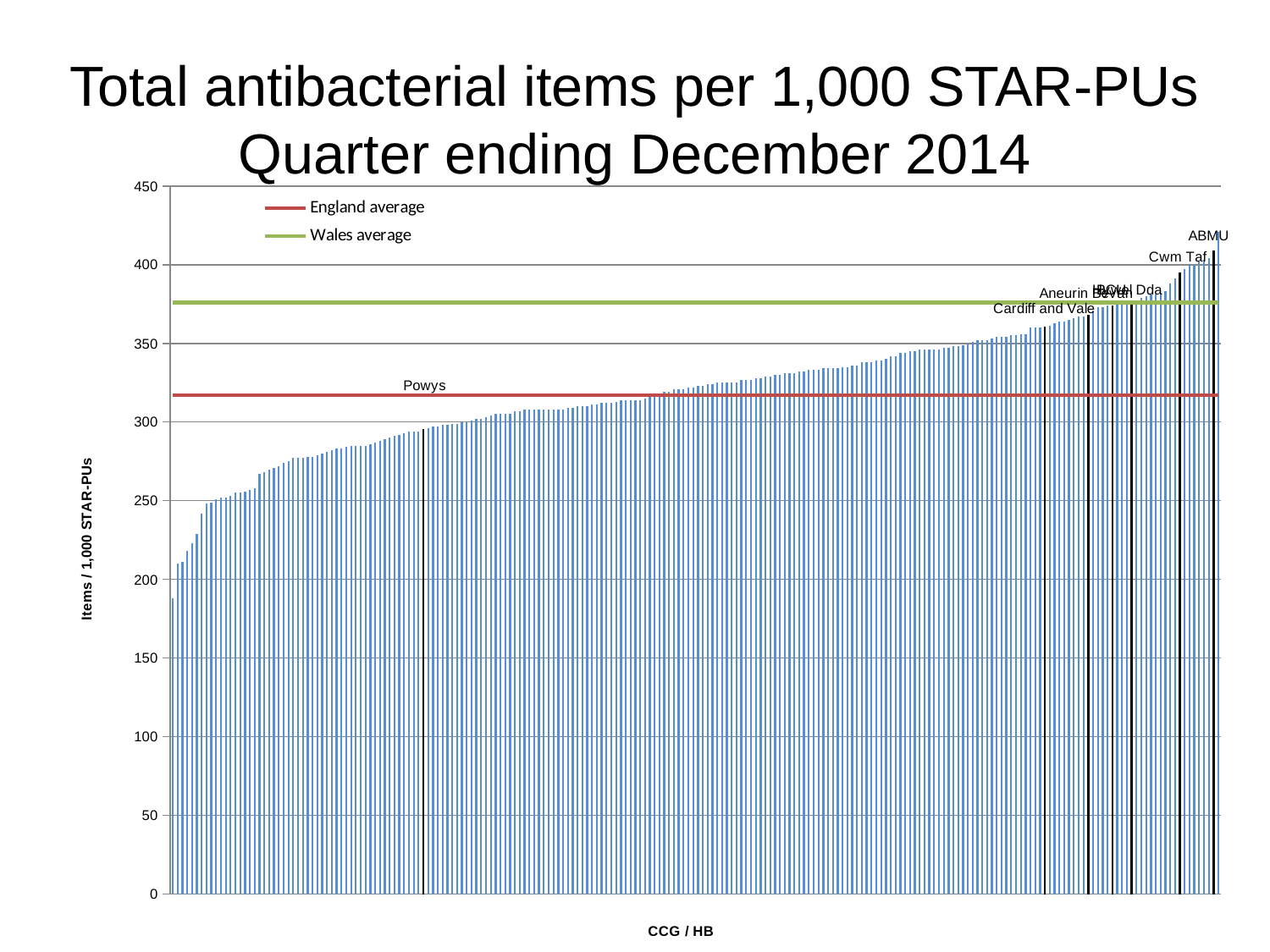
Is the value for Powys greater or less than 250? greater Which two lines does the legend list? England average and Wales average Is the value for Cardiff and Vale greater or less than 350? greater Which of the labelled health boards has the lowest value? Powys Do the bar values rise or fall from left to right along the x axis? rise Which of the labelled health boards has the highest value? ABMU Which is higher, the Wales average line or the England average line? Wales average Which is larger, the value for Cwm Taf or the value for Powys? Cwm Taf What kind of chart is shown on the slide? bar chart Is the value for ABMU greater or less than 400? greater What is the title of the y axis? Items / 1,000 STAR-PUs